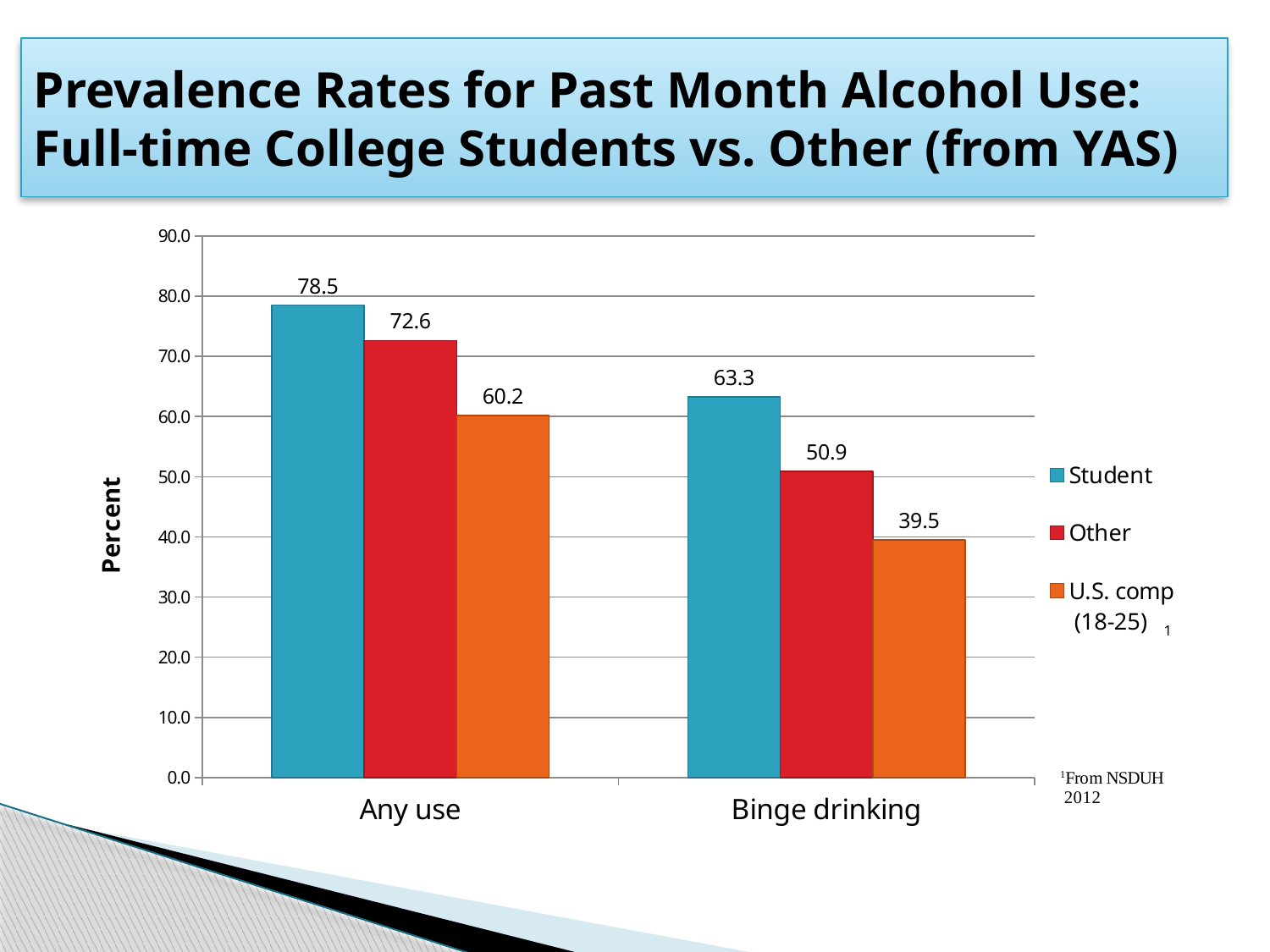
What kind of chart is shown on the slide? Bar chart What is the label of the y axis? Percent How many series does the legend list? 3 Which series has the highest value in the Binge drinking category? Student Which is larger: the Other value for Any use or the Student value for Binge drinking? Other value for Any use Which series has the lowest value in the Any use category? U.S. comp (18-25) What is the difference between the Student and Other values in the Any use category? 5.9 What is the value for Student in the Any use category? 78.5 How many categories are shown on the x axis? 2 What is the value for U.S. comp (18-25) in the Any use category? 60.2 What is the difference between the Student and U.S. comp (18-25) values in the Binge drinking category? 23.8 What is the value for Other in the Binge drinking category? 50.9